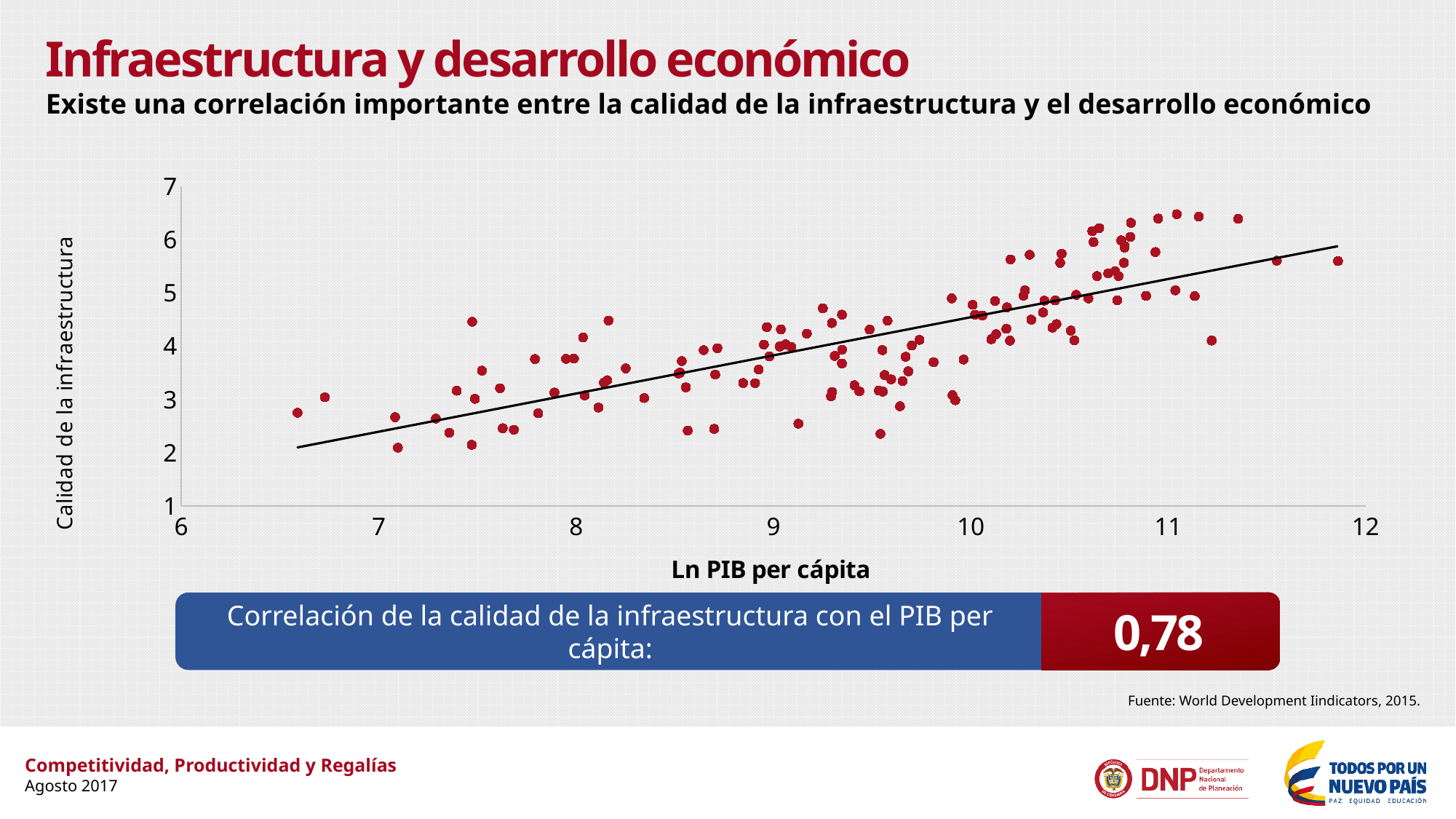
What is the label of the y axis of the chart? Calidad de la infraestructura Does the quality of infrastructure tend to rise or fall as Ln PIB per cápita increases along the x axis? rise What is the highest tick value shown on the x axis? 12 Is the fitted trend line's value at its right end (near Ln PIB per cápita of 12) greater or less than 5? greater What is the highest tick value shown on the y axis? 7 Is the fitted trend line's value at its left end (near Ln PIB per cápita of 6.6) greater or less than 3? less What is the label of the x axis of the chart? Ln PIB per cápita What kind of chart is shown on the slide? scatter plot